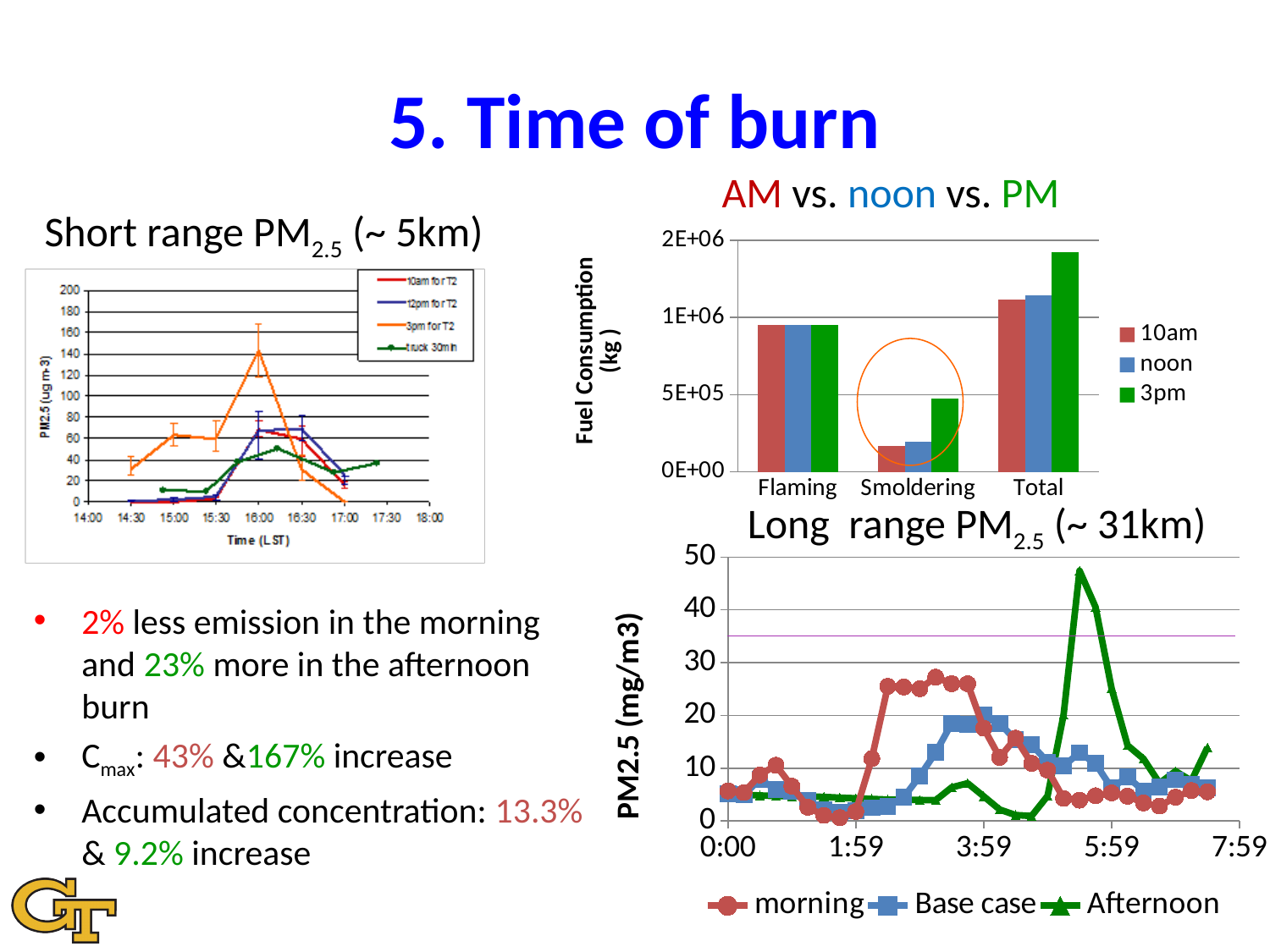
In the Fuel Consumption chart, is the 3pm value for Total greater or less than 1E+06? greater How many categories are shown on the x axis of the Fuel Consumption chart? 3 What kind of chart is the Long range PM2.5 (~ 31km) chart? line chart What kind of chart is the Fuel Consumption chart (AM vs. noon vs. PM)? bar chart In the Long range PM2.5 (~ 31km) chart, is the peak value of the Afternoon series greater or less than 40? greater In the Long range PM2.5 (~ 31km) chart, which series reaches the highest peak value? Afternoon In the Fuel Consumption chart, which is larger for Total: the 10am value or the 3pm value? 3pm In the Fuel Consumption chart, is the 10am value for Smoldering greater or less than 5E+05? less In the Fuel Consumption chart, which series has the highest value for Smoldering? 3pm How many series does the legend of the Short range PM2.5 (~ 5km) chart list? 4 How many series does the legend of the Fuel Consumption chart list? 3 How many series does the legend of the Long range PM2.5 (~ 31km) chart list? 3